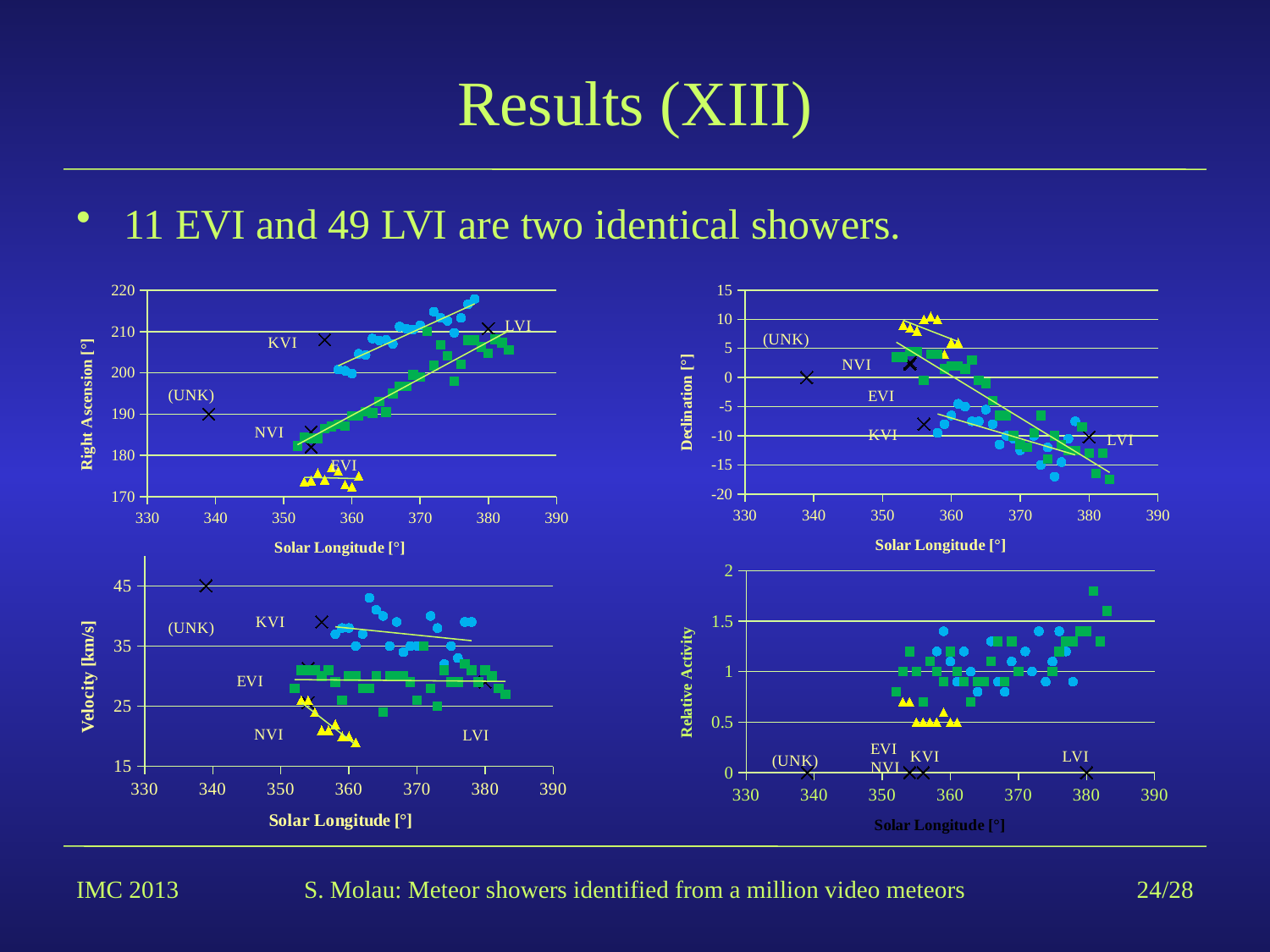
In the Relative Activity chart, is the value of the LVI X marker greater or less than 0.5? less In the Velocity chart, is the value of the KVI X marker greater or less than 35? greater What is the y-axis label of the top-left chart? Right Ascension [°] In the Velocity chart, is the value of the yellow triangle marker near solar longitude 361 greater or less than 25? less What kind of chart is the top-left chart (Right Ascension vs Solar Longitude)? scatter chart In the Declination chart, do the green square values rise or fall as solar longitude increases? fall In the Right Ascension chart, do the blue circle values rise or fall as solar longitude increases? rise How many charts are shown on the slide? 4